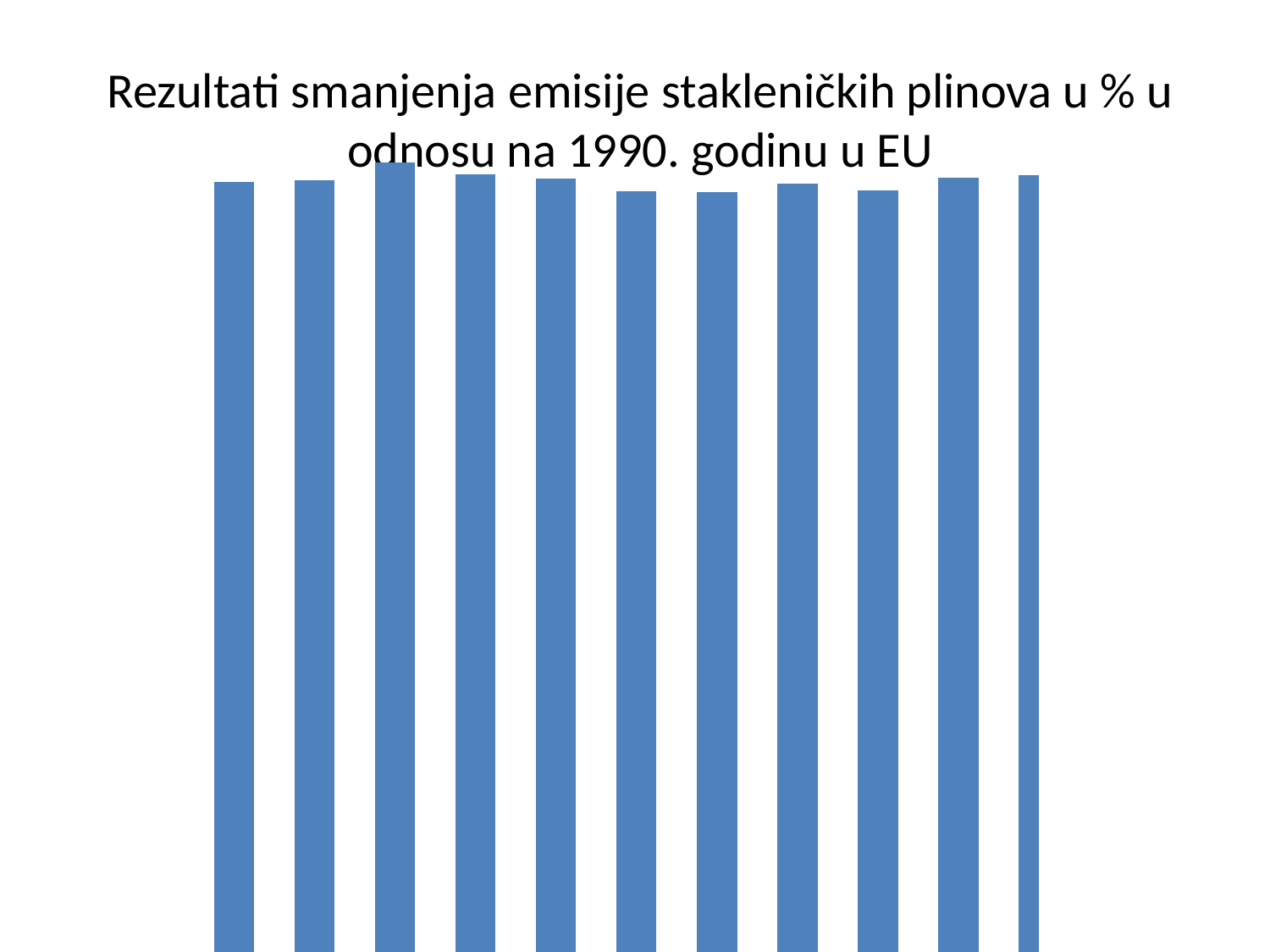
Counting from the left, which bar is the tallest in the chart? the third bar What kind of chart is shown on the slide? bar chart What is the title of the chart? Rezultati smanjenja emisije stakleničkih plinova u % u odnosu na 1990. godinu u EU Which is taller: the third bar from the left or the first bar from the left? the third bar What colour are the bars in the chart? blue How many bars does the chart contain? 11